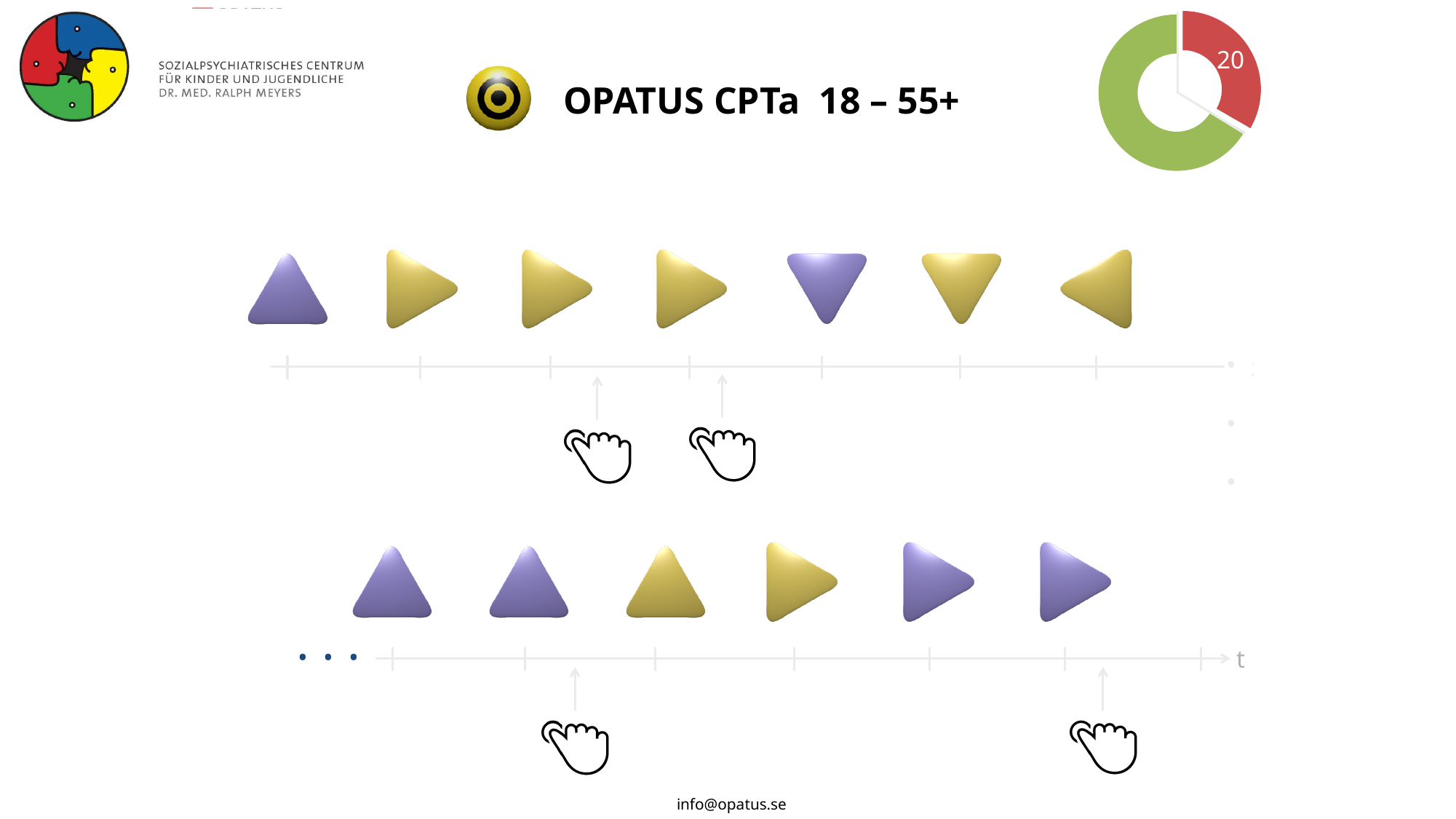
What colour is the slice of the doughnut chart that carries the data label? red How many data labels are printed on the doughnut chart? 1 Which slice of the doughnut chart is the smallest? the red slice In the doughnut chart, which slice is larger, the green one or the red one? green What kind of chart is shown in the top right corner of the slide? doughnut chart What value is printed on the red slice of the doughnut chart? 20 Which slice of the doughnut chart is the largest? the green slice How many slices does the doughnut chart in the top right have? 2